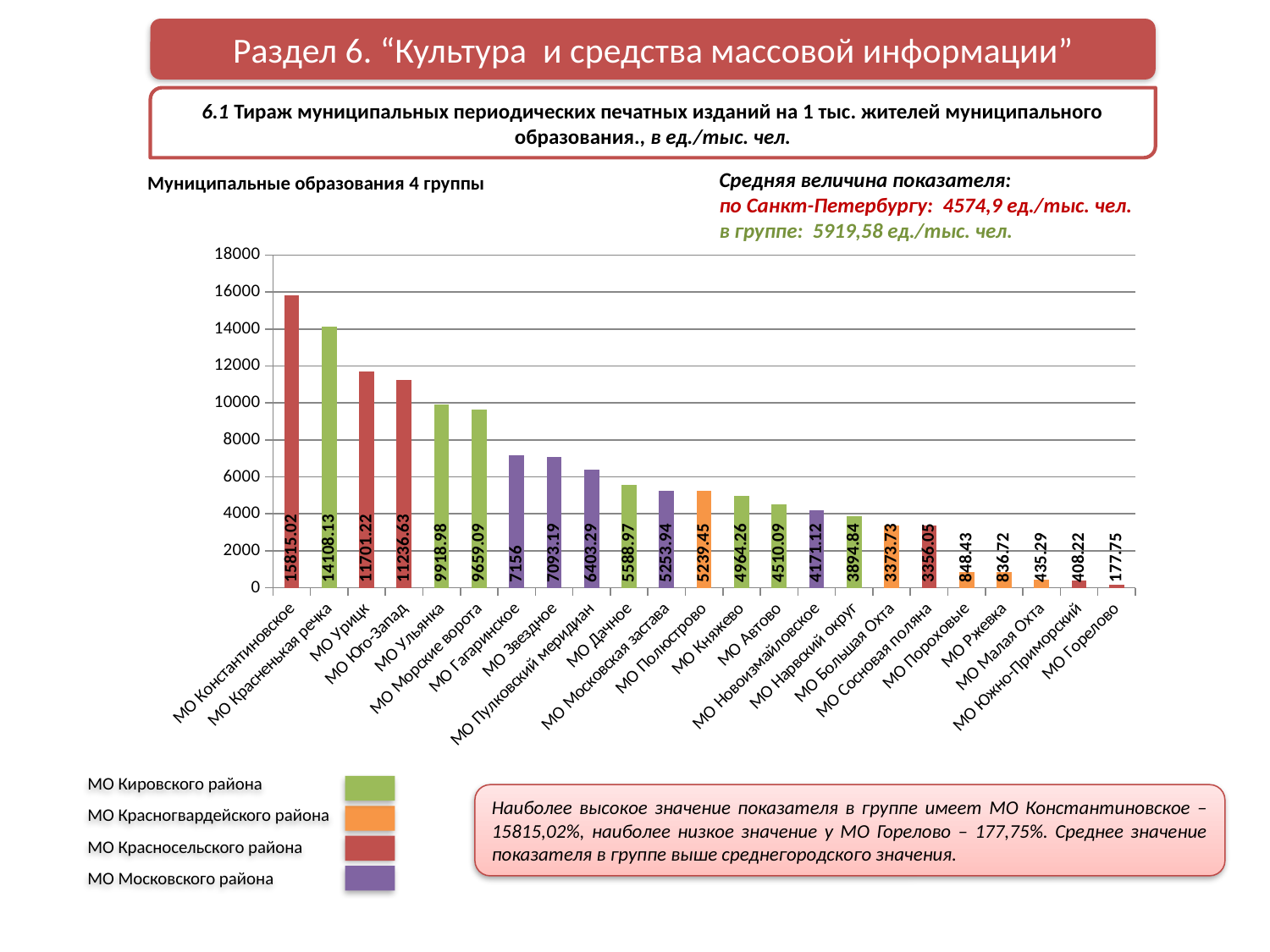
What is the value for МО Урицк? 11701.22 Which municipality has the lowest value on the chart? МО Горелово What kind of chart is shown on the slide? bar chart What is the value for МО Полюстрово? 5239.45 Which municipality has the highest value on the chart? МО Константиновское Is the value for МО Юго-Запад greater or less than 10000? greater What is the difference between the values for МО Константиновское and МО Красненькая речка? 1706.89 Which is larger, the value for МО Ульянка or the value for МО Дачное? МО Ульянка How many districts does the legend list? 4 How many municipalities are shown on the chart? 23 What is the value for МО Гагаринское? 7156 Do the values rise or fall from left to right along the x axis? fall